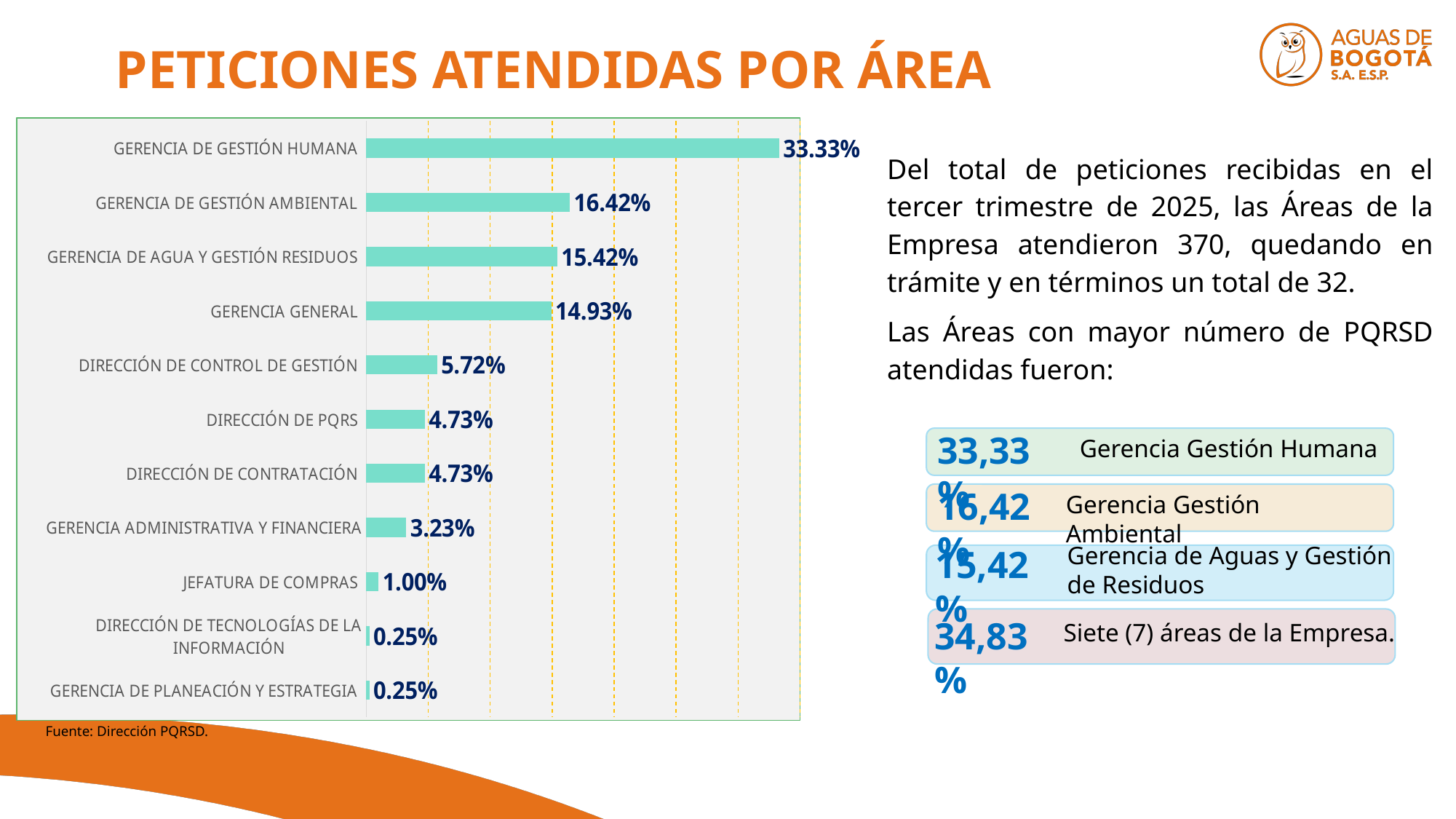
What is the value for JEFATURA DE COMPRAS? 1.00% What type of chart is shown on the slide? Bar chart What is the difference between the values for GERENCIA DE GESTIÓN AMBIENTAL and GERENCIA DE AGUA Y GESTIÓN RESIDUOS? 1.00% What is the difference between the values for GERENCIA DE GESTIÓN HUMANA and GERENCIA DE GESTIÓN AMBIENTAL? 16.91% Which area has the highest value in the chart? GERENCIA DE GESTIÓN HUMANA What is the value for GERENCIA ADMINISTRATIVA Y FINANCIERA? 3.23% Which is larger, the value for GERENCIA GENERAL or the value for DIRECCIÓN DE CONTROL DE GESTIÓN? GERENCIA GENERAL What is the value for GERENCIA GENERAL? 14.93% What is the value for GERENCIA DE GESTIÓN HUMANA? 33.33% What source is cited below the chart? Fuente: Dirección PQRSD. How many areas (categories) are shown in the chart? 11 What is the value for DIRECCIÓN DE CONTROL DE GESTIÓN? 5.72%